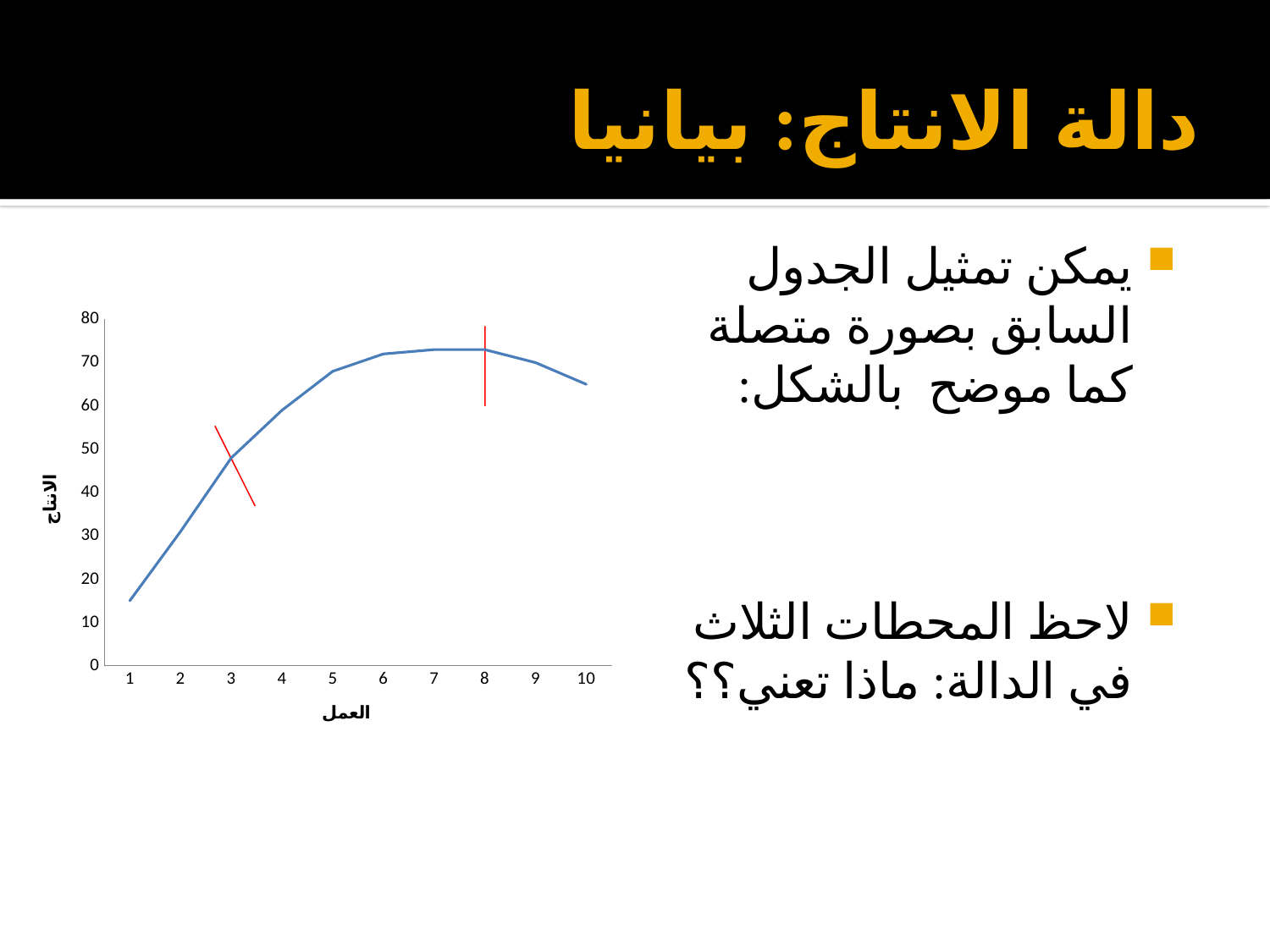
Which x-axis value has the lowest plotted value? 1 Is the value at x = 4 greater or less than 50? greater Is the value at x = 1 greater or less than 20? less What is the title of the x axis of the chart? العمل How many points are plotted along the x axis of the chart? 10 Do the values rise or fall from x = 8 to x = 10? fall What kind of chart is shown on the slide? line chart Do the values rise or fall from x = 1 to x = 5? rise Is the value at x = 5 greater or less than 60? greater Which is larger, the value at x = 1 or the value at x = 10? x = 10